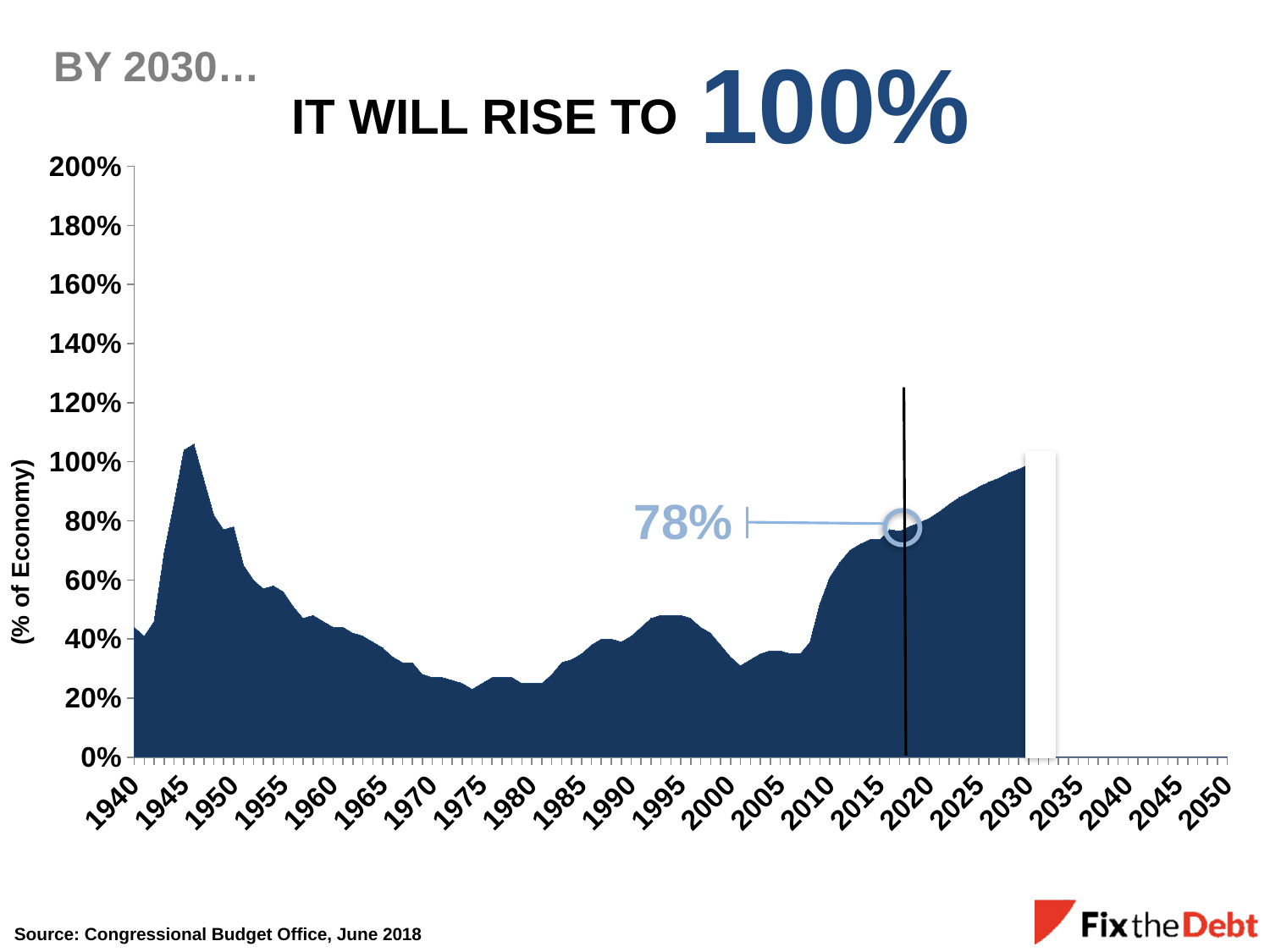
Do the values rise or fall between 1950 and 1975? fall Which year has the larger value, 1950 or 2000? 1950 What is the source cited for the chart? Congressional Budget Office, June 2018 What value is labelled at the circled point on the chart (around 2018)? 78% Which year has the larger value, 1975 or 1995? 1995 What kind of chart is shown on the slide? area chart Is the peak value in the late 1940s greater or less than 80%? greater Do the values rise or fall between 2010 and 2030? rise What is the highest value shown on the y axis? 200% Is the value for 2005 greater or less than 60%? less According to the slide title, what level will the value rise to by 2030? 100% Is the value for 1975 greater or less than 40%? less